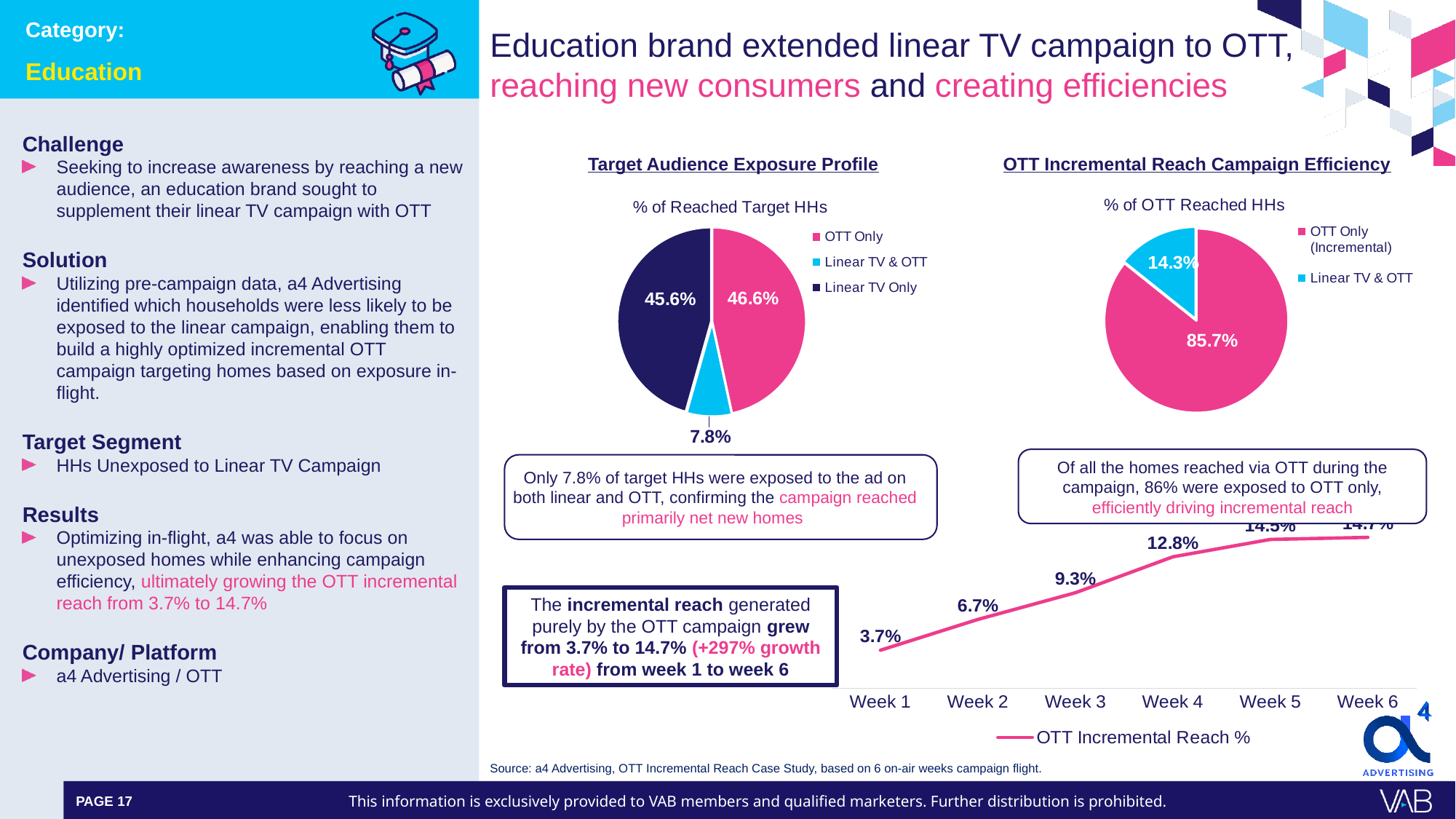
In the OTT Incremental Reach % line chart, what is the value for Week 4? 12.8% In the OTT Incremental Reach Campaign Efficiency pie chart, which segment is larger: OTT Only (Incremental) or Linear TV & OTT? OTT Only (Incremental) What kind of chart is the OTT Incremental Reach % chart at the bottom right of the slide? Line chart In the Target Audience Exposure Profile pie chart, which segment is the smallest? Linear TV & OTT In the Target Audience Exposure Profile pie chart, what percentage of reached target households were OTT Only? 46.6% In the Target Audience Exposure Profile pie chart, what share of reached target households were exposed to both Linear TV & OTT? 7.8% In the OTT Incremental Reach % line chart, what is the value for Week 1? 3.7% In the Target Audience Exposure Profile pie chart, what percentage of reached target households were Linear TV Only? 45.6% In the Target Audience Exposure Profile pie chart, how many segments does the legend list? 3 In the OTT Incremental Reach Campaign Efficiency pie chart, what percentage of OTT reached households were OTT Only (Incremental)? 85.7% In the OTT Incremental Reach % line chart, does the value rise or fall from Week 1 to Week 6? Rise In the OTT Incremental Reach Campaign Efficiency pie chart, what is the difference between the OTT Only (Incremental) share and the Linear TV & OTT share? 71.4%